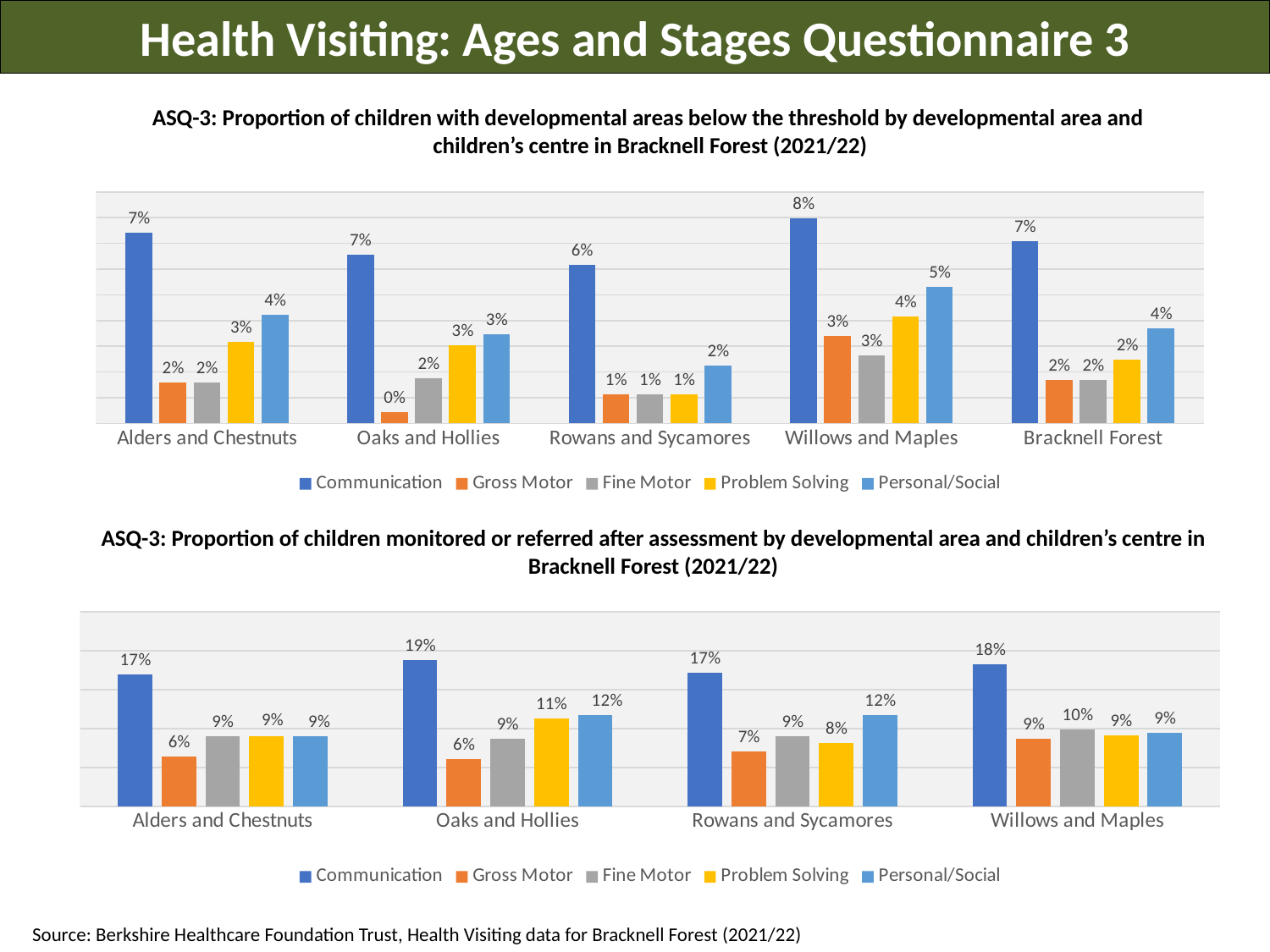
In the bottom chart (children monitored or referred), how many children's centre categories are shown on the x axis? 4 In the bottom chart (children monitored or referred), is the Personal/Social value larger for Oaks and Hollies or for Willows and Maples? Oaks and Hollies In the bottom chart (children monitored or referred), what is the Problem Solving value for Rowans and Sycamores? 8% In the top chart (children below the threshold), how many series does the legend list? 5 In the top chart (children below the threshold), which children's centre has the highest Communication value? Willows and Maples In the bottom chart (children monitored or referred), which children's centre has the highest Communication value? Oaks and Hollies What type of chart is the bottom chart (children monitored or referred)? Bar chart In the top chart (children below the threshold), how many children's centre categories are shown on the x axis? 5 In the top chart (children below the threshold), what is the Communication value for Willows and Maples? 8% In the top chart (children below the threshold), what is the Gross Motor value for Oaks and Hollies? 0% In the bottom chart (children monitored or referred), what is the Communication value for Oaks and Hollies? 19% In the top chart (children below the threshold), what is the difference between the Personal/Social values for Willows and Maples and Rowans and Sycamores? 3%